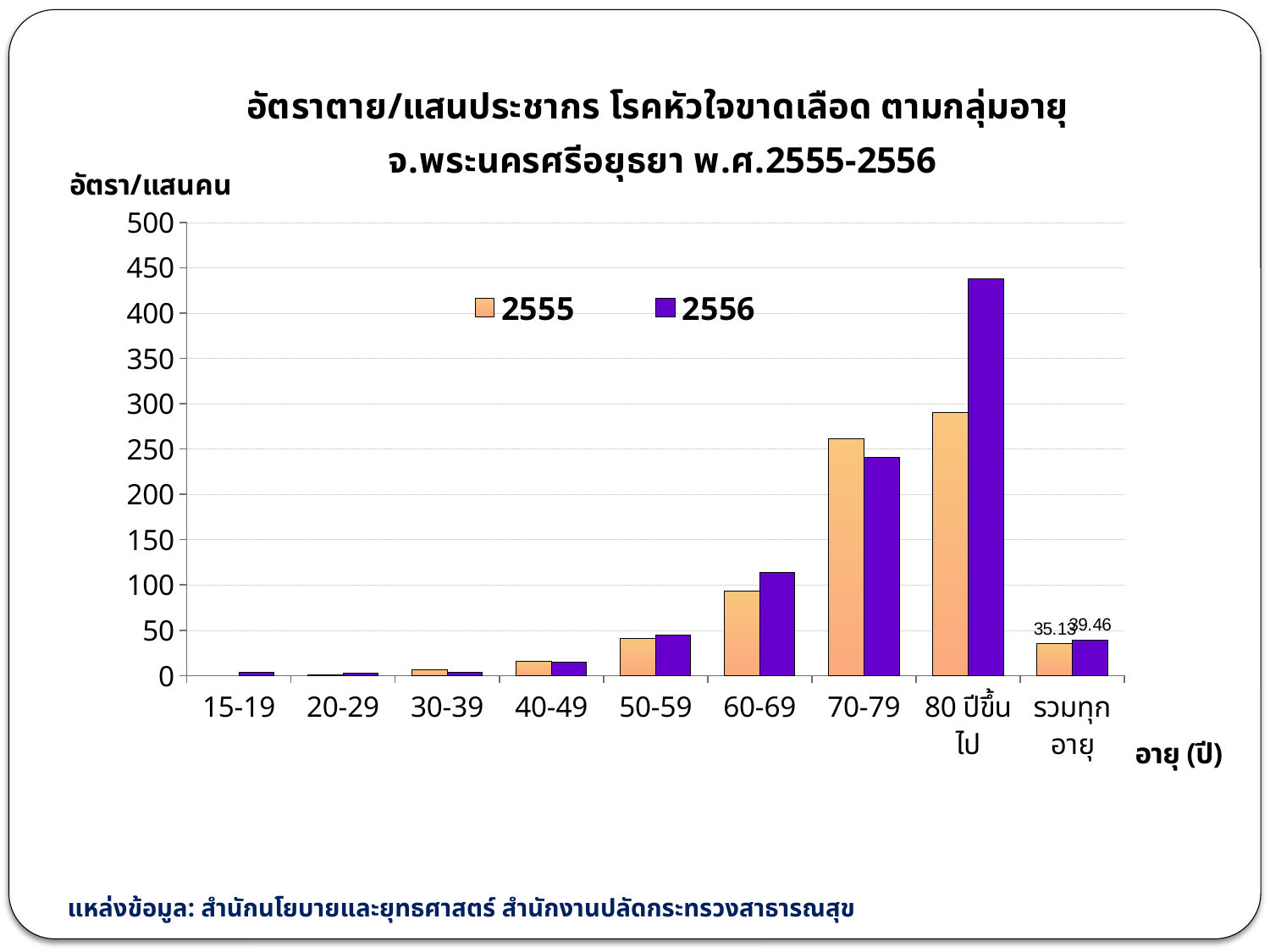
What is the value for the 2556 series in the รวมทุกอายุ category? 39.46 Is the value for 2556 in the 60-69 category greater or less than 100? greater What is the value for the 2555 series in the รวมทุกอายุ category? 35.13 Is the value for 2556 in the 80 ปีขึ้นไป category greater or less than 400? greater Is the value for 2555 in the 80 ปีขึ้นไป category greater or less than 300? less What kind of chart is shown on the slide? bar chart In the 70-79 category, which series has the larger value, 2555 or 2556? 2555 In the รวมทุกอายุ category, which series has the larger value, 2555 or 2556? 2556 What is the difference between the 2556 and 2555 values in the รวมทุกอายุ category? 4.33 Which age group has the highest value for the 2556 series? 80 ปีขึ้นไป How many series does the legend list? 2 How many age-group categories are shown on the x axis? 9